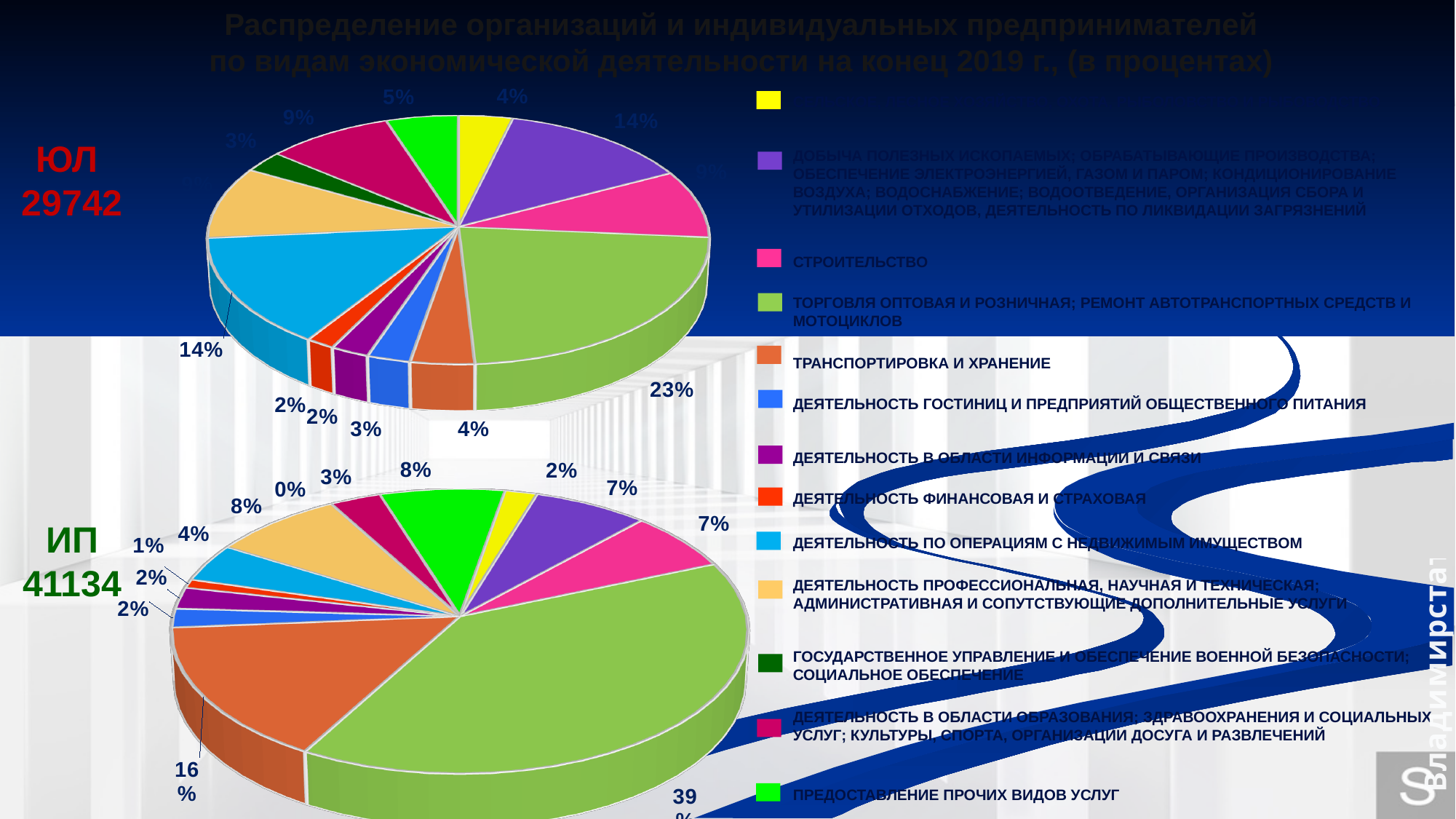
In the bottom pie chart (ИП 41134), what share is shown for ДЕЯТЕЛЬНОСТЬ ПРОФЕССИОНАЛЬНАЯ, НАУЧНАЯ И ТЕХНИЧЕСКАЯ; АДМИНИСТРАТИВНАЯ И СОПУТСТВУЮЩИЕ ДОПОЛНИТЕЛЬНЫЕ УСЛУГИ? 8% In the bottom pie chart (ИП 41134), how many percentage points larger is the trade slice (39%) than the transport and storage slice (16%)? 23 How many entries does the legend list? 13 In the top pie chart (ЮЛ 29742), what share is shown for ДЕЯТЕЛЬНОСТЬ ПО ОПЕРАЦИЯМ С НЕДВИЖИМЫМ ИМУЩЕСТВОМ? 14% In the bottom pie chart (ИП 41134), what share is shown for ТОРГОВЛЯ ОПТОВАЯ И РОЗНИЧНАЯ; РЕМОНТ АВТОТРАНСПОРТНЫХ СРЕДСТВ И МОТОЦИКЛОВ? 39% In the bottom pie chart (ИП 41134), which category has the largest share? ТОРГОВЛЯ ОПТОВАЯ И РОЗНИЧНАЯ; РЕМОНТ АВТОТРАНСПОРТНЫХ СРЕДСТВ И МОТОЦИКЛОВ In the bottom pie chart (ИП 41134), what share is shown for ТРАНСПОРТИРОВКА И ХРАНЕНИЕ? 16% In the bottom pie chart (ИП 41134), which is larger: СТРОИТЕЛЬСТВО or ДЕЯТЕЛЬНОСТЬ ПО ОПЕРАЦИЯМ С НЕДВИЖИМЫМ ИМУЩЕСТВОМ? СТРОИТЕЛЬСТВО In the top pie chart (ЮЛ 29742), what share is shown for ПРЕДОСТАВЛЕНИЕ ПРОЧИХ ВИДОВ УСЛУГ? 5% What type of charts are shown on the slide? pie charts In the bottom pie chart (ИП 41134), which category has the smallest share? ГОСУДАРСТВЕННОЕ УПРАВЛЕНИЕ И ОБЕСПЕЧЕНИЕ ВОЕННОЙ БЕЗОПАСНОСТИ; СОЦИАЛЬНОЕ ОБЕСПЕЧЕНИЕ In the top pie chart (ЮЛ 29742), which is larger: the mining/manufacturing/energy category (purple) or СТРОИТЕЛЬСТВО? the mining/manufacturing/energy category